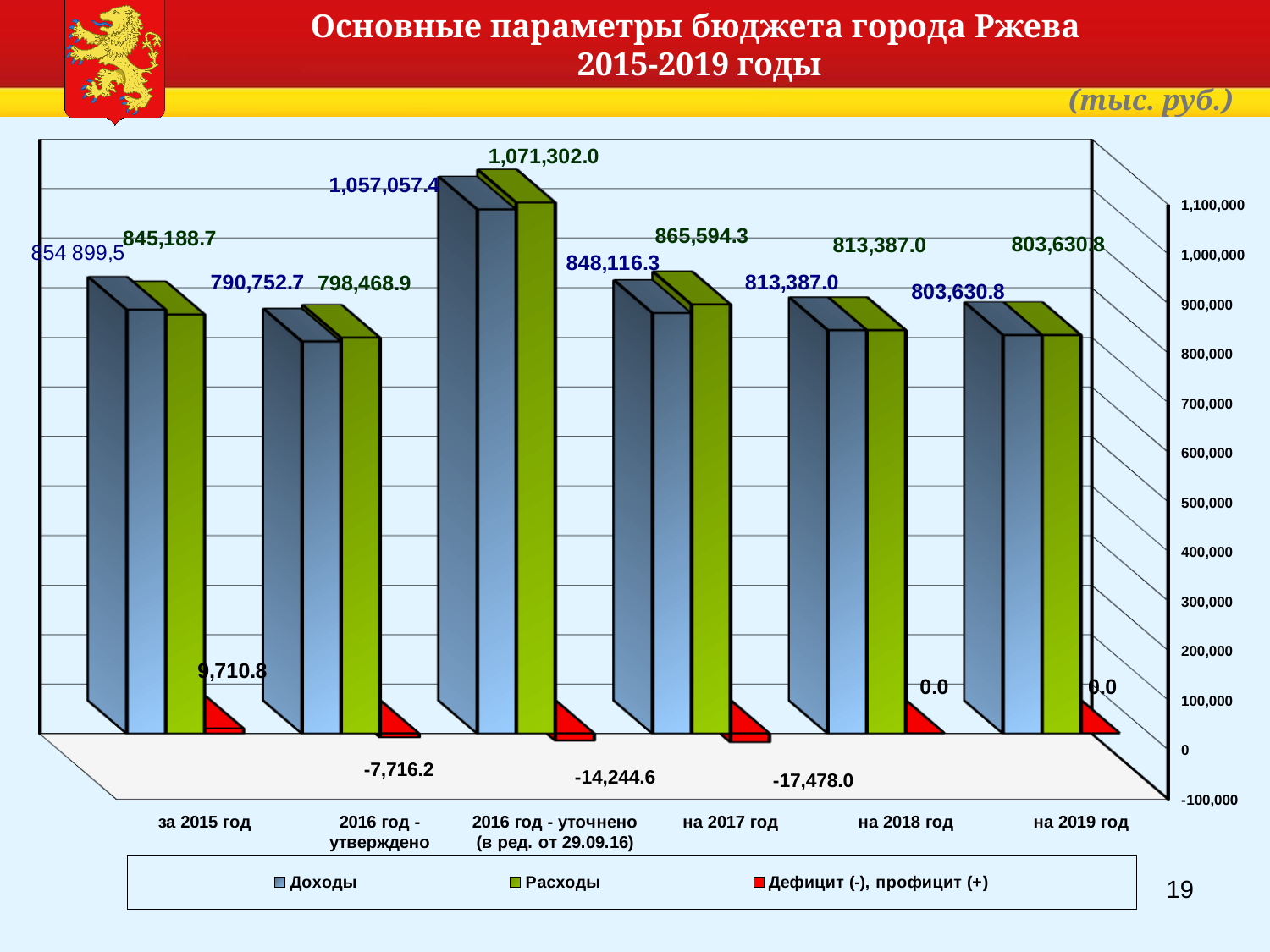
How many categories are shown on the x axis? 6 For '2016 год - утверждено', what is the difference between Расходы and Доходы? 7,716.2 For 'на 2017 год', how much larger is Расходы than Доходы? 17,478.0 What is the value of Расходы for '2016 год - уточнено (в ред. от 29.09.16)'? 1,071,302.0 What is the value of 'Дефицит (-), профицит (+)' for 'на 2018 год'? 0.0 For 'за 2015 год', which is larger: Доходы or Расходы? Доходы What kind of chart is shown on the slide? Bar chart Which category has the lowest value of Расходы? 2016 год - утверждено How many series does the legend list? 3 What is the value of Доходы for 'на 2017 год'? 848,116.3 Which category has the highest value of Доходы? 2016 год - уточнено (в ред. от 29.09.16) What is the value of 'Дефицит (-), профицит (+)' for 'на 2017 год'? -17,478.0